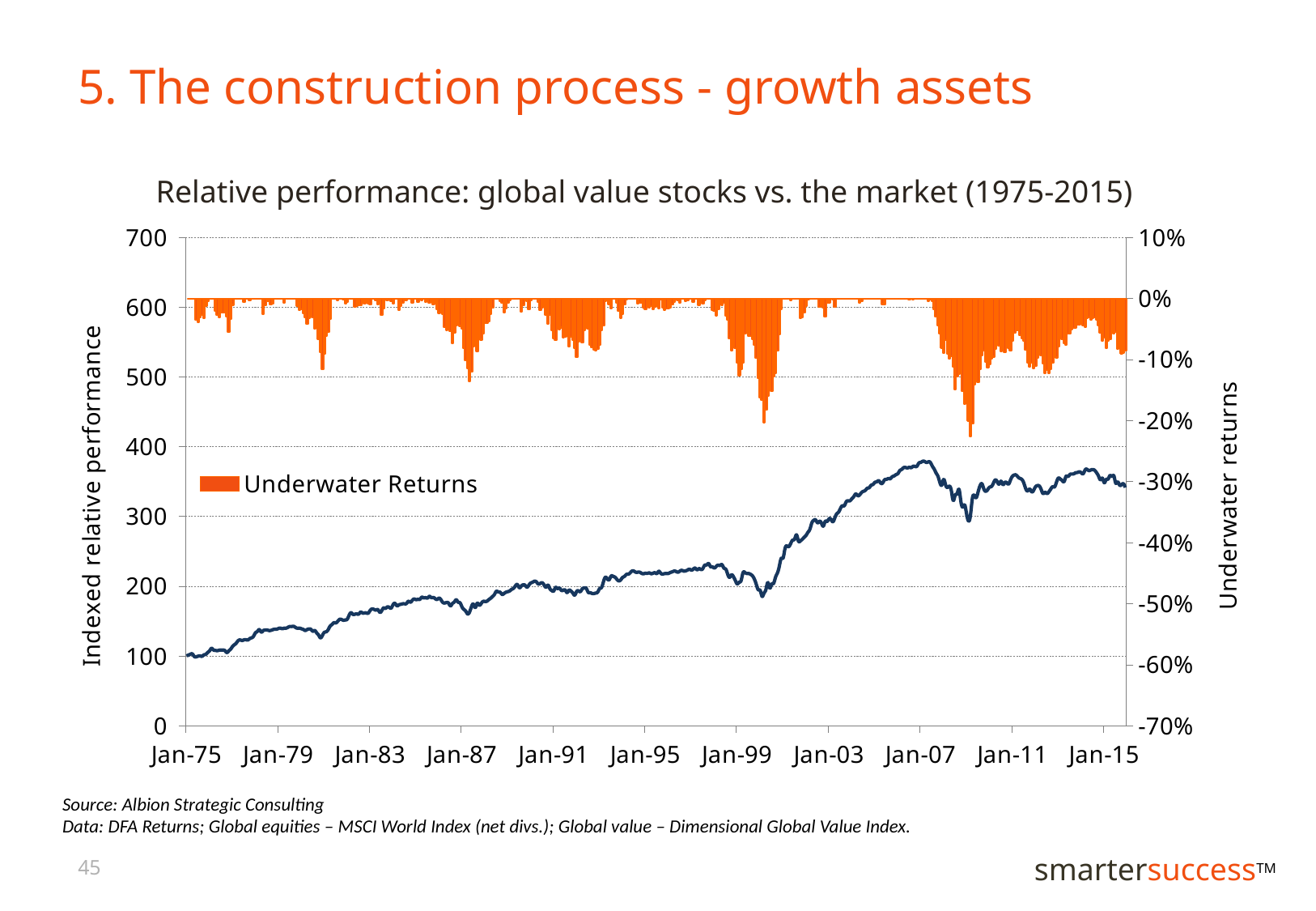
What series name appears in the chart's legend? Underwater Returns What is the label of the right-hand vertical axis? Underwater returns How many date labels are shown on the x axis of the chart? 11 What is the title of the chart? Relative performance: global value stocks vs. the market (1975-2015) Is the indexed relative performance value at Jan-07 greater or less than 300? greater How many series does the chart's legend list? 1 Is the indexed relative performance value at Jan-75 greater or less than 200? less What kind of chart is shown on the slide? A combined line and bar chart Does the indexed relative performance line rise or fall overall from Jan-75 to Jan-15? rise Is the indexed relative performance value at Jan-07 greater or less than the value at Jan-75? greater Is the indexed relative performance value at Jan-15 greater or less than 300? greater